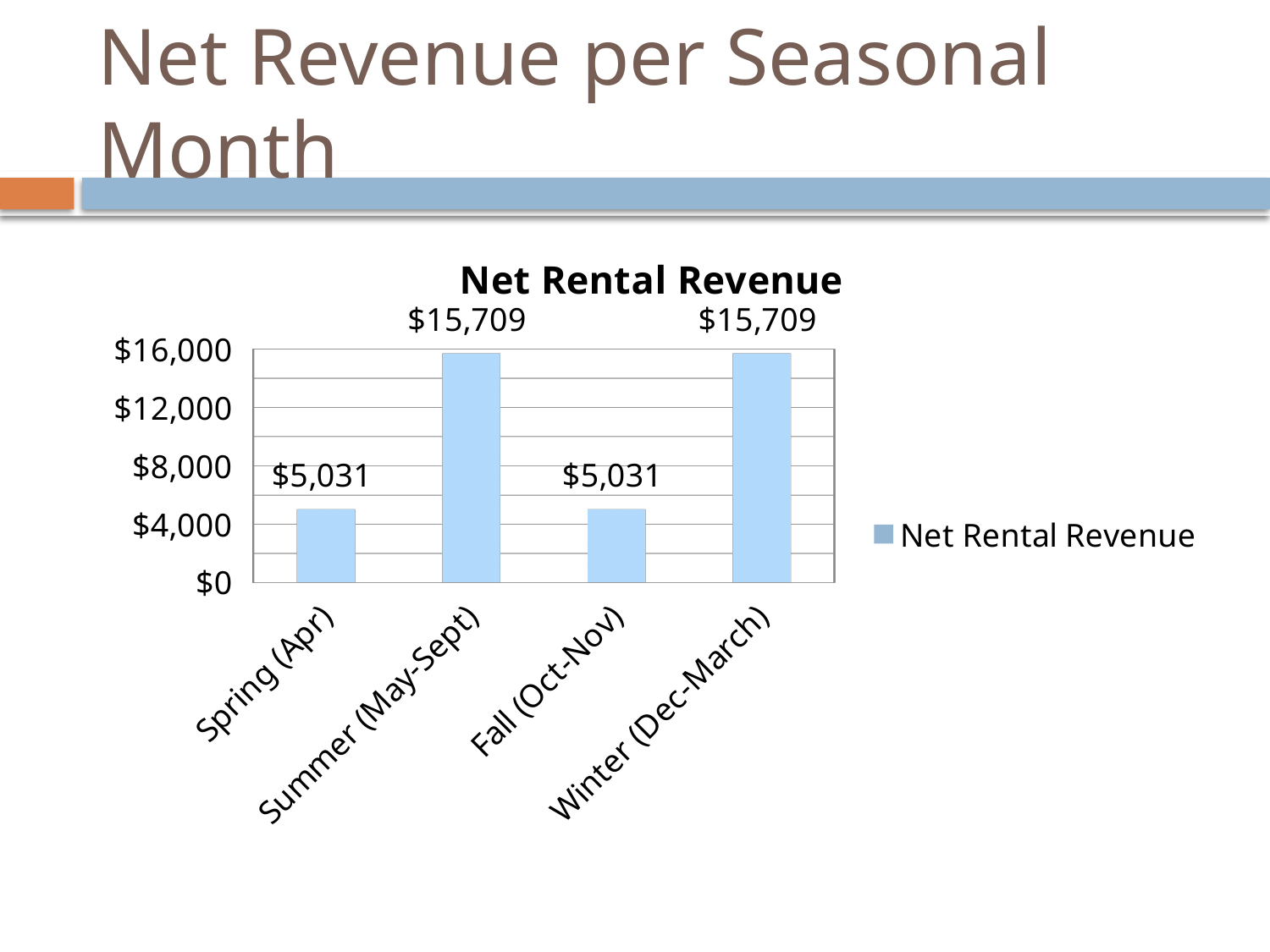
What is the net rental revenue for Fall (Oct-Nov)? $5,031 What is the title of the chart? Net Rental Revenue What is the net rental revenue for Spring (Apr)? $5,031 Which has the larger net rental revenue, Winter (Dec-March) or Fall (Oct-Nov)? Winter (Dec-March) How many series does the legend list? 1 What is the difference between the net rental revenue for Summer (May-Sept) and Spring (Apr)? $10,678 What kind of chart is shown on the slide? bar chart Is the net rental revenue for Spring (Apr) greater or less than $8,000? less What is the net rental revenue for Summer (May-Sept)? $15,709 What is the net rental revenue for Winter (Dec-March)? $15,709 How many seasonal categories are shown on the chart? 4 Is the net rental revenue for Winter (Dec-March) greater or less than $12,000? greater